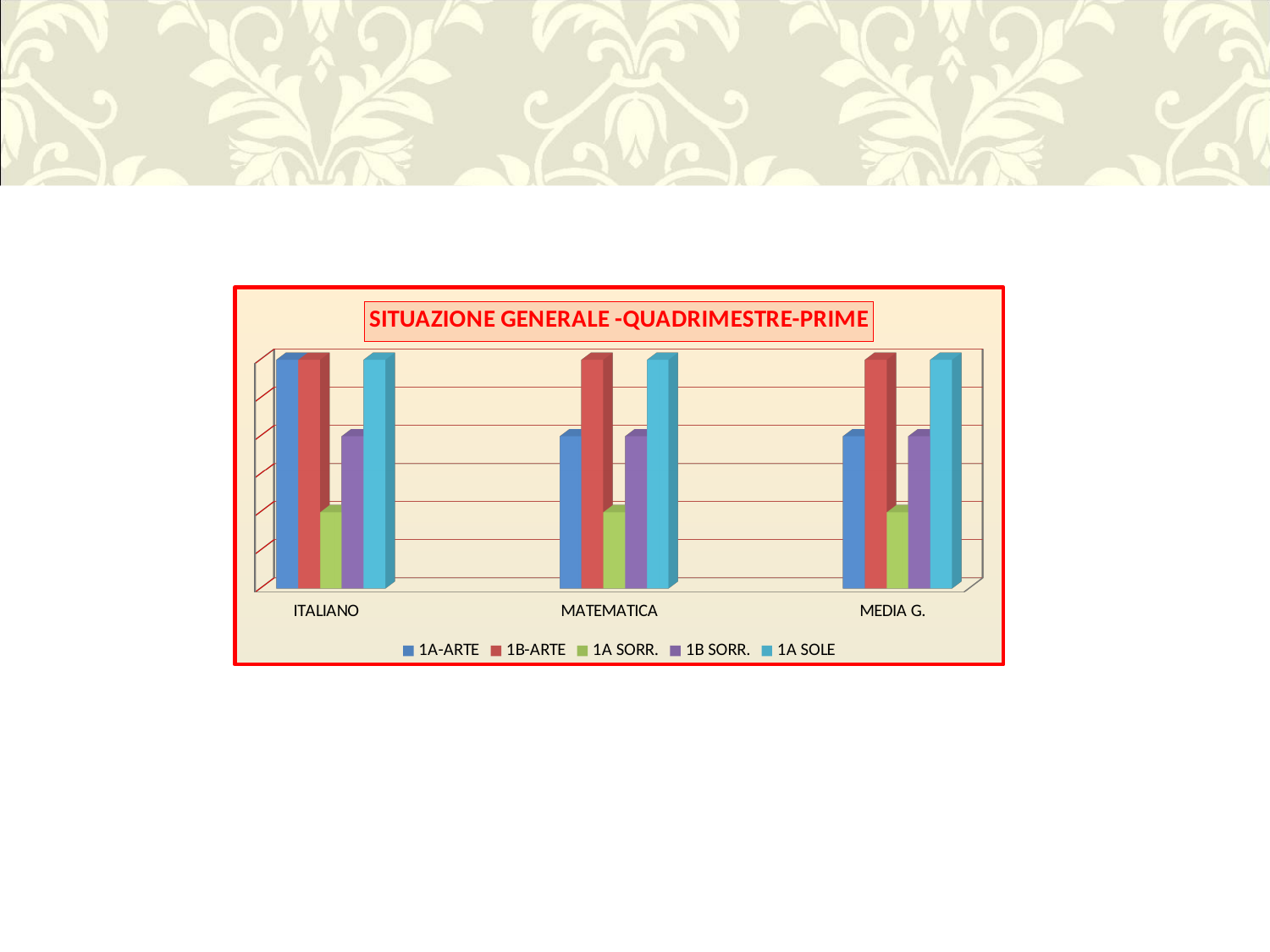
How many categories are shown on the x axis of the chart? 3 What kind of chart is shown on the slide? bar chart For ITALIANO, which is larger: the value for 1B SORR. or the value for 1A SORR.? 1B SORR. Which series is shown in green in the chart's legend? 1A SORR. For MATEMATICA, which is larger: the value for 1B-ARTE or the value for 1A SORR.? 1B-ARTE Which series has the lowest value for MATEMATICA? 1A SORR. For MEDIA G., which is larger: the value for 1A SOLE or the value for 1B SORR.? 1A SOLE Which series has the lowest value for ITALIANO? 1A SORR. Which series has the lowest value for MEDIA G.? 1A SORR. What is the title of the chart? SITUAZIONE GENERALE -QUADRIMESTRE-PRIME How many series does the chart's legend list? 5